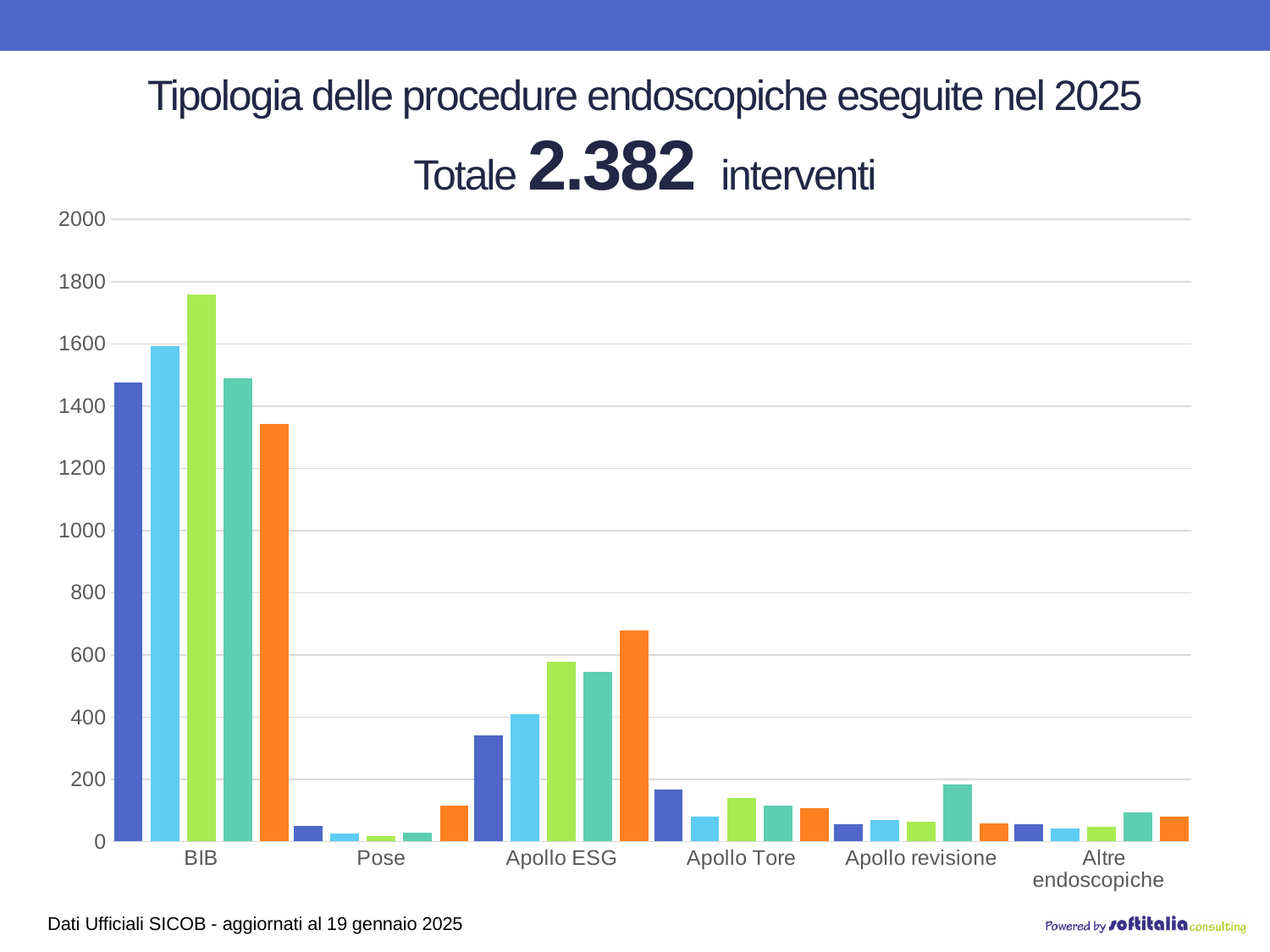
How many categories are shown on the x axis of the chart? 6 Is the value of the orange bar for BIB greater or less than 1400? less What total number of interventions is stated in the chart title? 2.382 What kind of chart is shown on the slide? bar chart Which category has the highest bars in the chart? BIB Is the value of the dark blue bar for Apollo Tore greater or less than 200? less Which category has the lowest bars in the chart? Pose Is the value of the orange bar for Apollo ESG greater or less than 600? greater Which category has larger values, BIB or Apollo ESG? BIB How many bars are plotted for each category in the chart? 5 Which has the larger dark blue bar, Apollo Tore or Apollo revisione? Apollo Tore